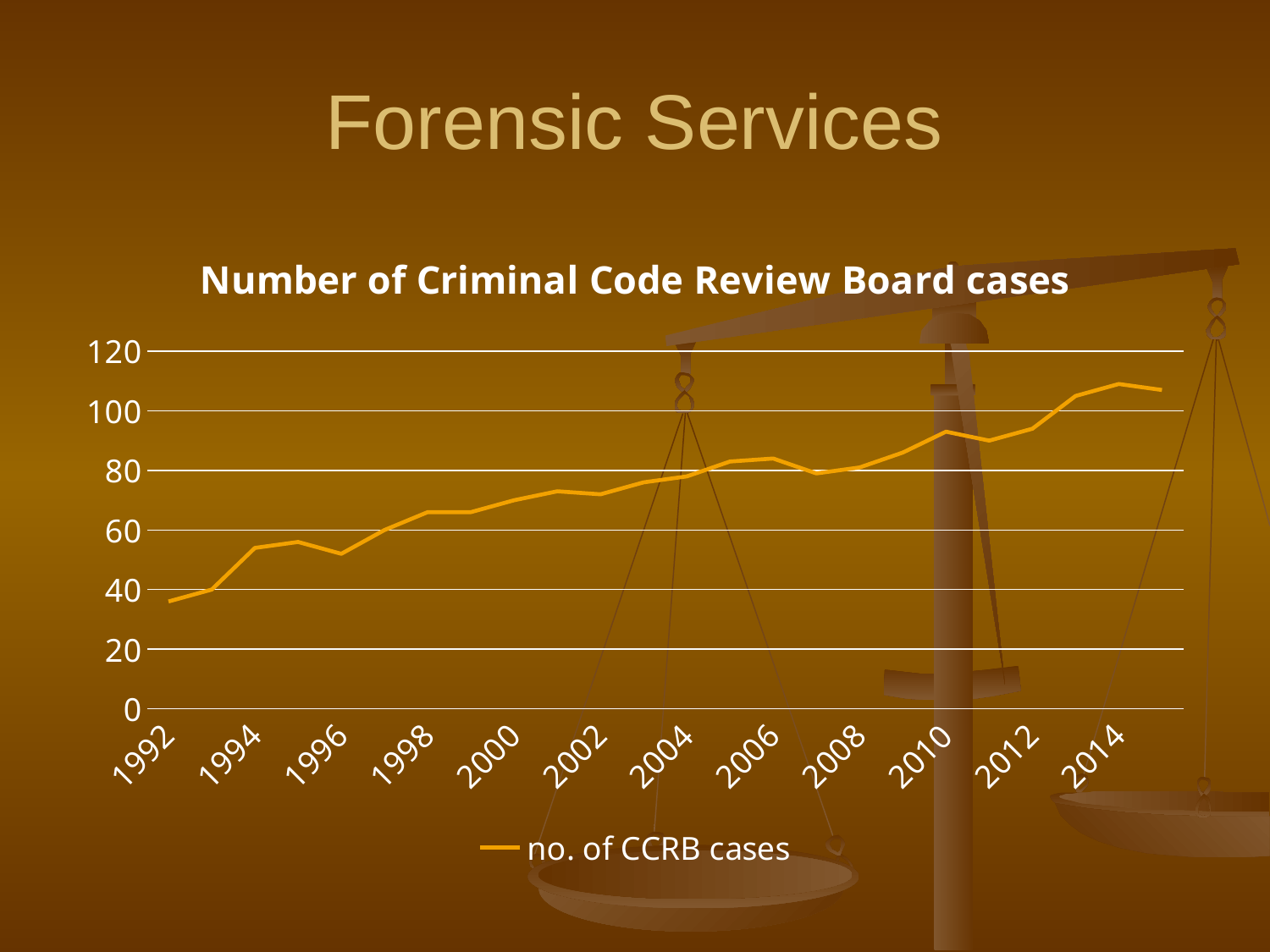
Is the value for 1992 greater or less than 40? less What is the name of the series shown in the legend? no. of CCRB cases Is the value for 2010 greater or less than 80? greater Overall, do the number of CCRB cases rise or fall from 1992 to 2014? rise What kind of chart is shown on the slide? line chart Is the value for 2000 greater or less than 60? greater Which year has more CCRB cases, 2000 or 2010? 2010 Which labelled year has the lowest number of CCRB cases? 1992 How many series does the legend list? 1 What is the title of the chart? Number of Criminal Code Review Board cases